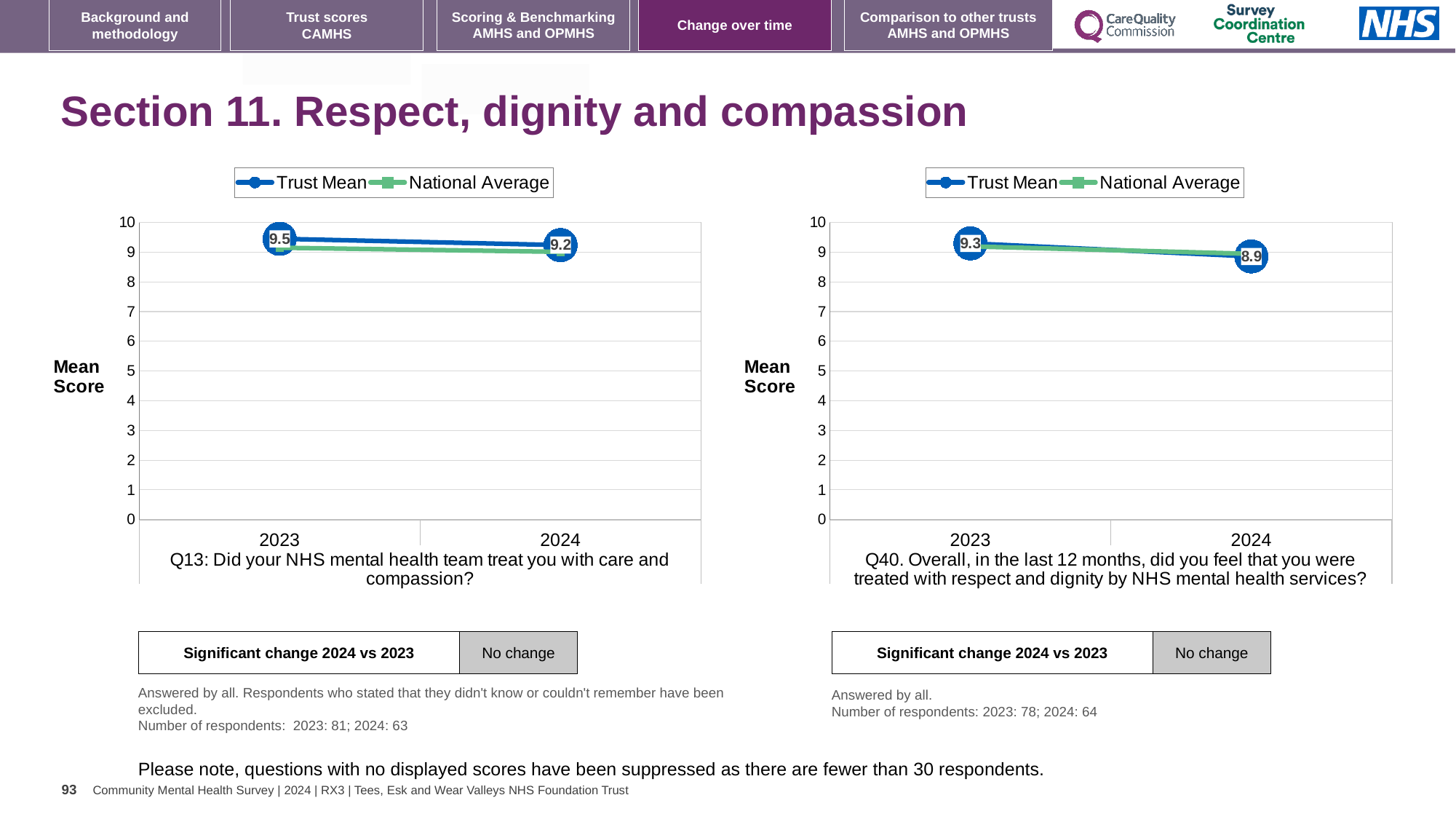
How many years are shown on the x axis of the Q13 chart (left)? 2 On the Q13 chart (left), is the National Average for 2024 greater or less than 8? greater How many series does the legend of the Q40 chart (right) list? 2 On the Q40 chart (right), what is the Trust Mean for 2024? 8.9 On the Q40 chart (right), does the Trust Mean rise or fall from 2023 to 2024? fall On the Q13 chart (left), by how much did the Trust Mean change from 2023 to 2024? 0.3 Which series is shown in green on the Q13 chart (left)? National Average What type of chart is the Q13 chart on the left? line chart On the Q40 chart (right), what is the difference between the Trust Mean in 2023 and 2024? 0.4 On the Q40 chart (right), what is the Trust Mean for 2023? 9.3 On the Q13 chart (left), what is the Trust Mean for 2024? 9.2 On the Q13 chart (left), what is the Trust Mean for 2023? 9.5